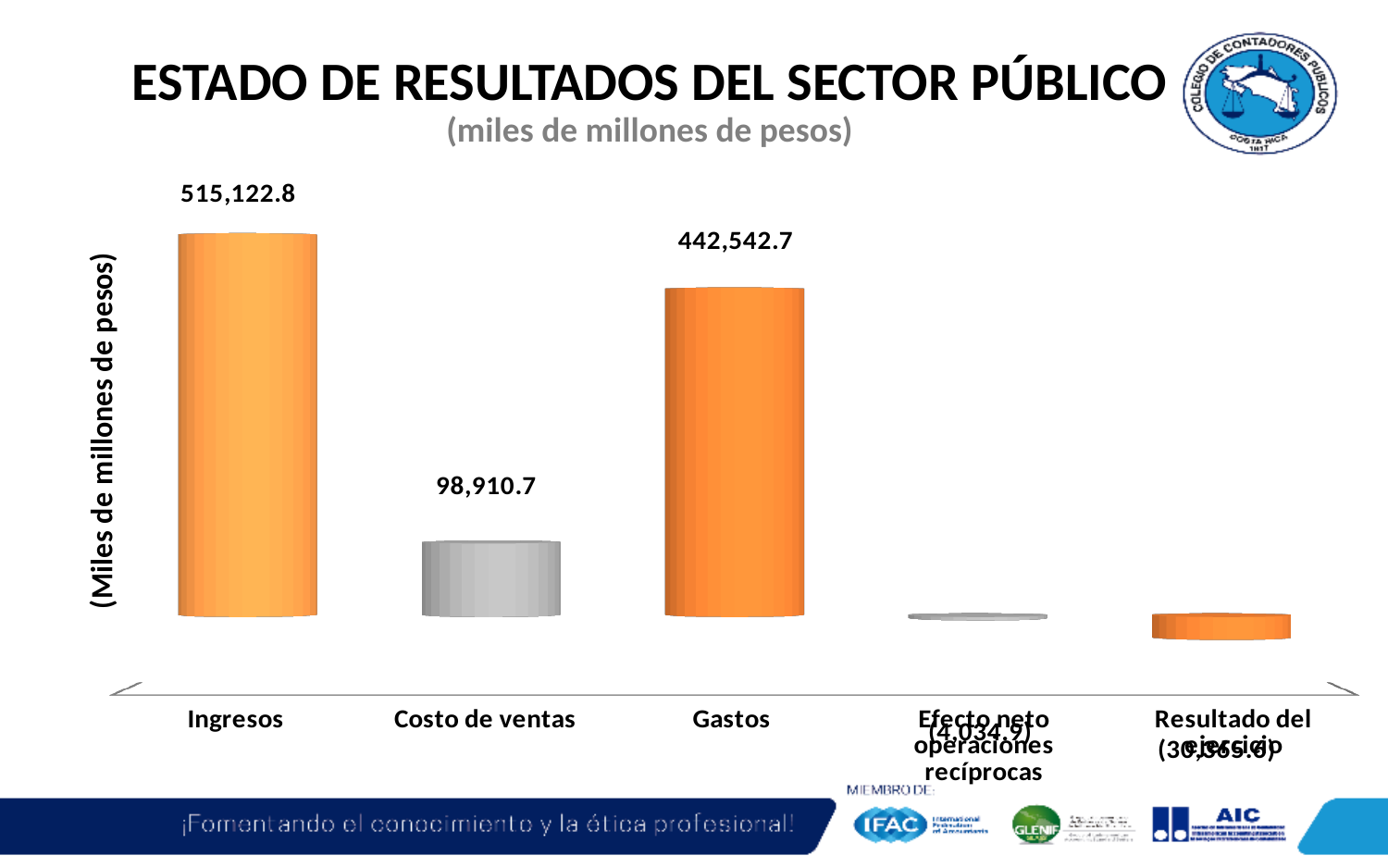
What is the title of the chart? ESTADO DE RESULTADOS DEL SECTOR PÚBLICO How many categories are shown on the x axis? 5 Which category has the highest value? Ingresos What is the difference between Ingresos and Costo de ventas? 416,212.1 Which is larger, Gastos or Costo de ventas? Gastos What is the value for Ingresos? 515,122.8 What is the value for Costo de ventas? 98,910.7 What is the difference between Ingresos and Gastos? 72,580.1 What kind of chart is shown on the slide? Bar chart What is the value for Gastos? 442,542.7 What is the label on the vertical axis? (Miles de millones de pesos) Which is larger, Ingresos or Gastos? Ingresos